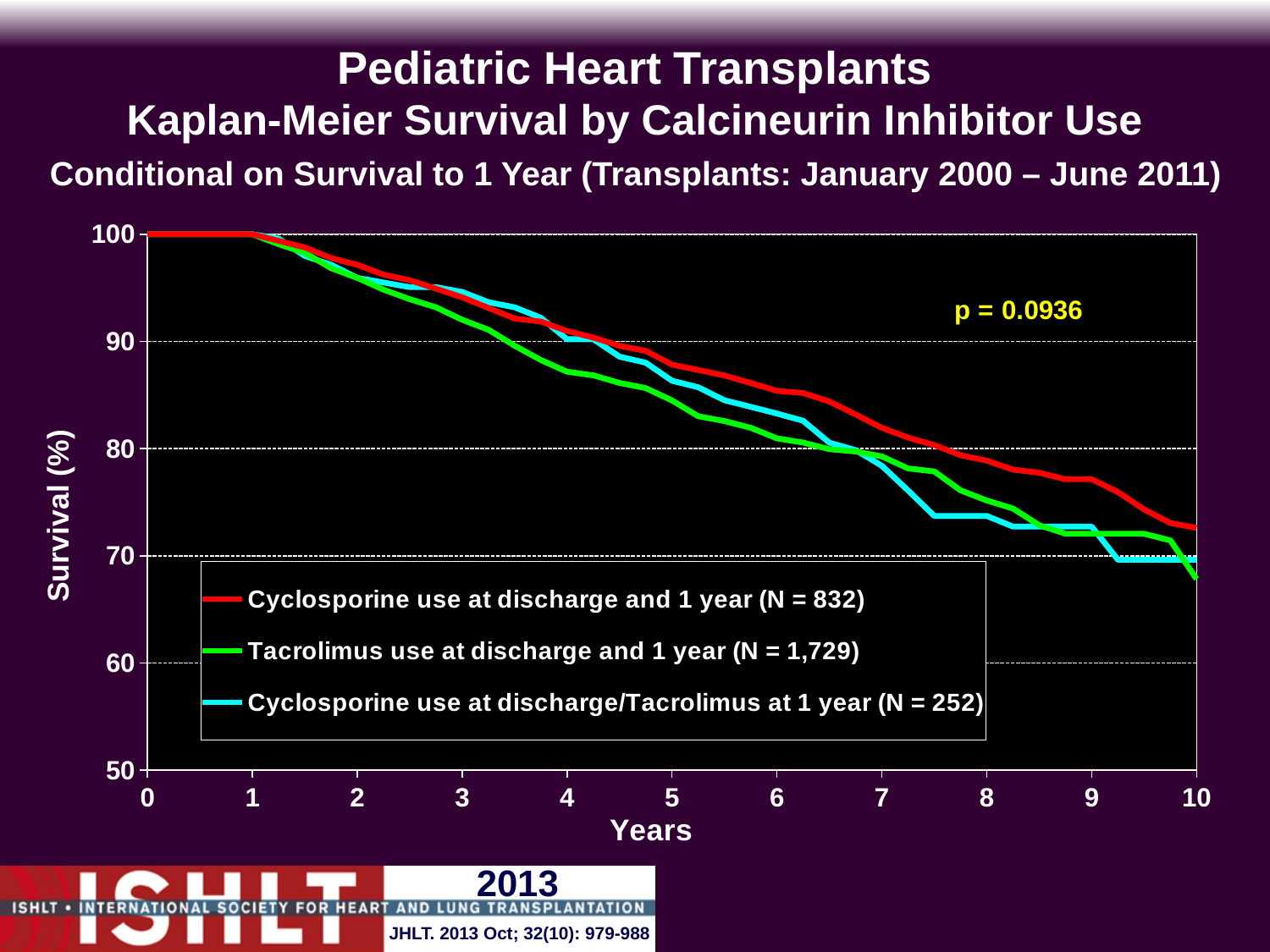
What is the N for the Tacrolimus use at discharge and 1 year group? 1,729 Is the survival for Cyclosporine use at discharge and 1 year at 10 years greater or less than 70? greater What is the label of the y axis? Survival (%) How many series does the legend list? 3 Is the survival for Tacrolimus use at discharge and 1 year at 10 years greater or less than 70? less What is the N for the Cyclosporine use at discharge/Tacrolimus at 1 year group? 252 What p-value is printed on the chart? p = 0.0936 Do the survival curves rise or fall as years increase? fall At 8 years, which group has higher survival: Cyclosporine use at discharge and 1 year or Cyclosporine use at discharge/Tacrolimus at 1 year? Cyclosporine use at discharge and 1 year What kind of chart is shown on the slide? line chart At 4 years, which group has higher survival: Cyclosporine use at discharge and 1 year or Tacrolimus use at discharge and 1 year? Cyclosporine use at discharge and 1 year